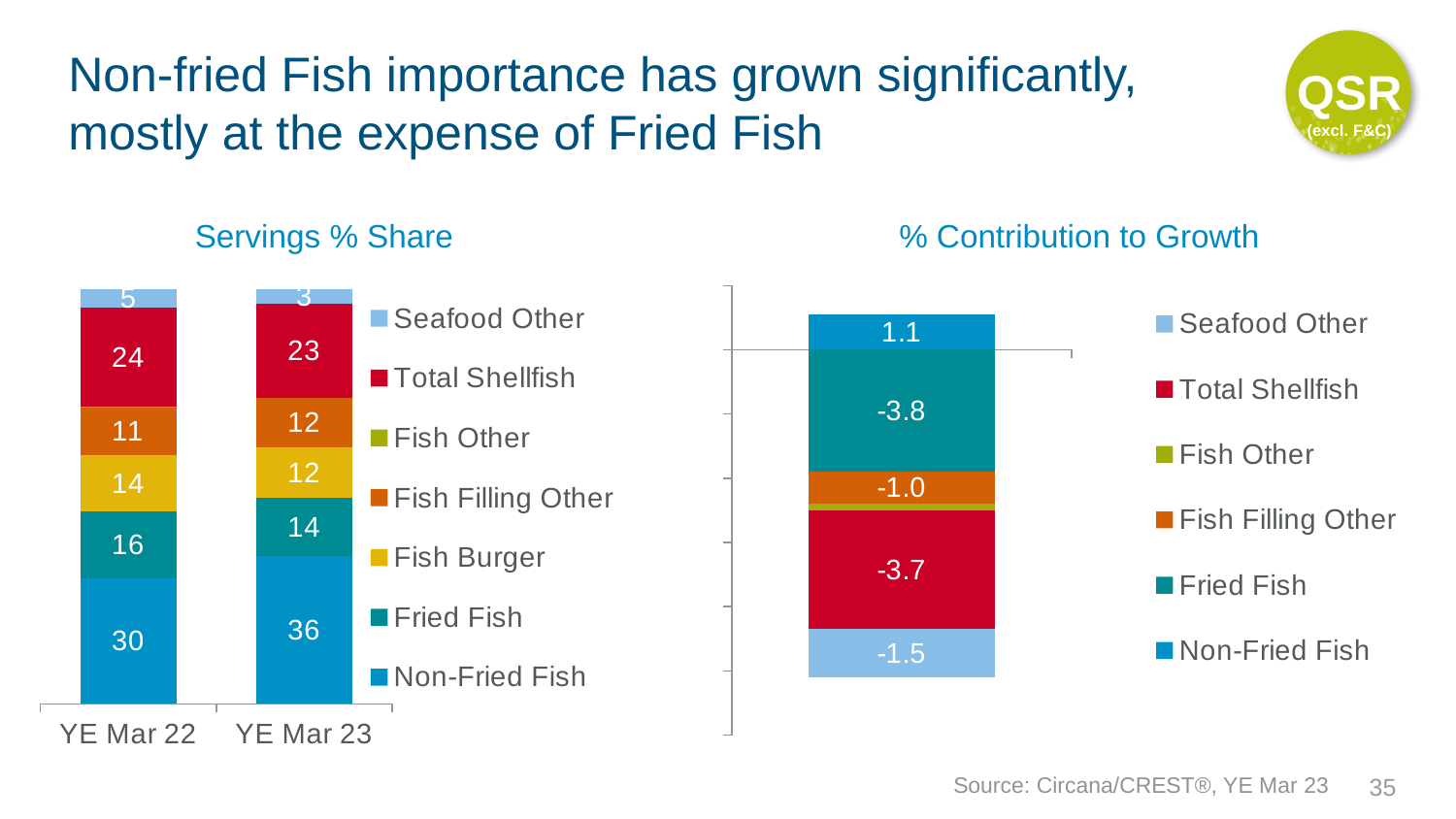
In the Servings % Share chart, what is the value for Fried Fish in YE Mar 22? 16 What kind of chart is the Servings % Share chart? Stacked bar chart How many series does the legend of the % Contribution to Growth chart list? 6 In the % Contribution to Growth chart, what is the value for Non-Fried Fish? 1.1 How many series does the legend of the Servings % Share chart list? 7 In the Servings % Share chart, what is the value for Non-Fried Fish in YE Mar 23? 36 What is the title of the chart on the right side of the slide? % Contribution to Growth In the % Contribution to Growth chart, what is the value for Fried Fish? -3.8 In the Servings % Share chart, by how much did the Non-Fried Fish share increase from YE Mar 22 to YE Mar 23? 6 How many bars are shown in the Servings % Share chart? 2 In the Servings % Share chart, is the Total Shellfish share larger in YE Mar 22 or YE Mar 23? YE Mar 22 In the Servings % Share chart, what is the value for Fish Burger in YE Mar 23? 12